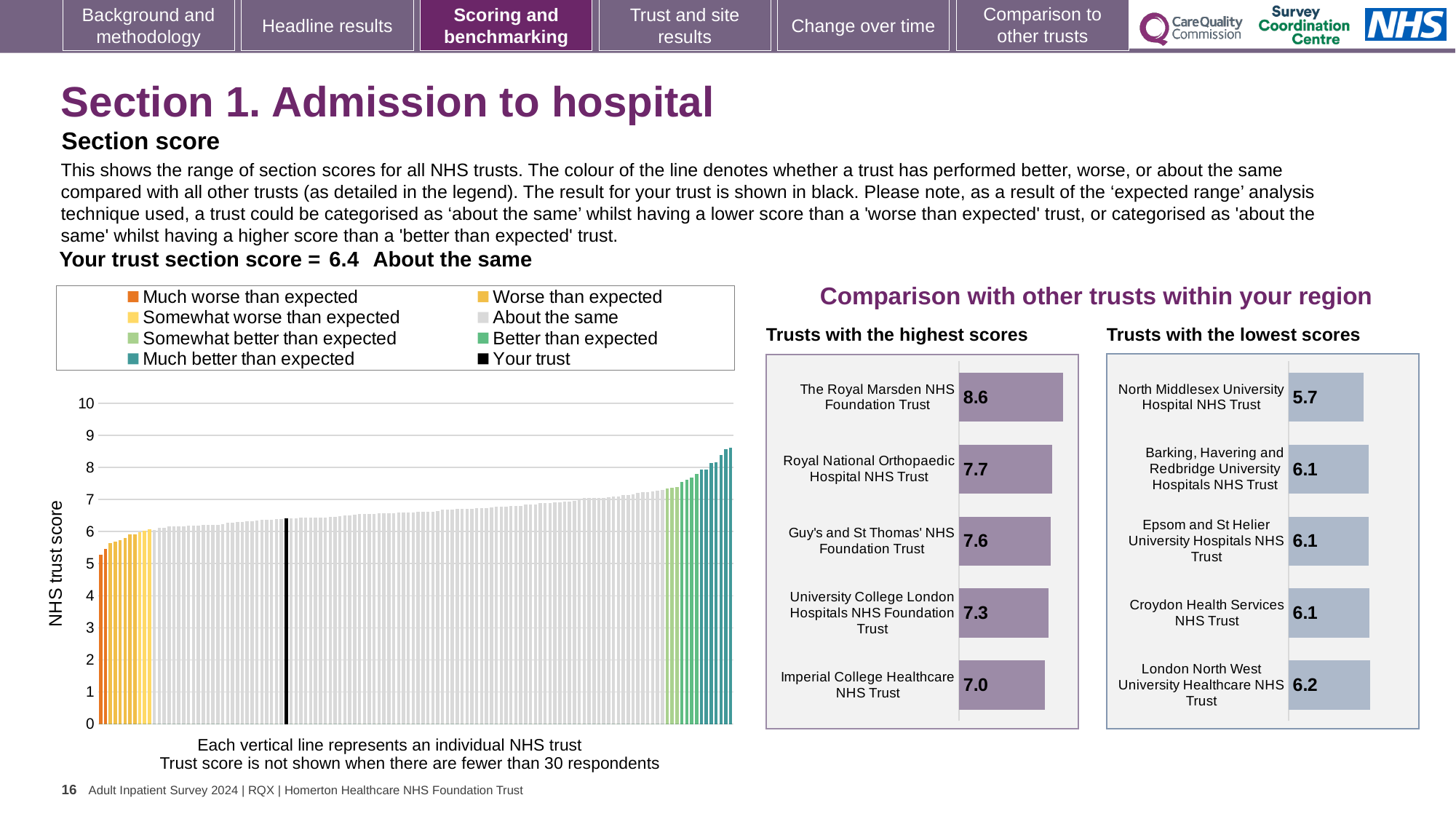
How many entries does the legend of the large chart on the left list? 8 In the 'Trusts with the lowest scores' chart, what is the difference between the scores of London North West University Healthcare NHS Trust and North Middlesex University Hospital NHS Trust? 0.5 In the 'Trusts with the highest scores' chart, what is the score for The Royal Marsden NHS Foundation Trust? 8.6 Which is larger: the score for Guy's and St Thomas' NHS Foundation Trust in the highest scores chart, or the score for Croydon Health Services NHS Trust in the lowest scores chart? Guy's and St Thomas' NHS Foundation Trust How many trusts are shown in the 'Trusts with the highest scores' chart? 5 In the 'Trusts with the highest scores' chart, what is the score for Imperial College Healthcare NHS Trust? 7.0 In the 'Trusts with the lowest scores' chart, what is the score for North Middlesex University Hospital NHS Trust? 5.7 In the 'Trusts with the lowest scores' chart, what is the score for London North West University Healthcare NHS Trust? 6.2 In the 'Trusts with the lowest scores' chart, which trust has the lowest score? North Middlesex University Hospital NHS Trust In the large chart on the left, do the trust scores rise or fall from left to right? rise In the 'Trusts with the highest scores' chart, which trust has the highest score? The Royal Marsden NHS Foundation Trust In the 'Trusts with the highest scores' chart, what is the difference between the scores of The Royal Marsden NHS Foundation Trust and Imperial College Healthcare NHS Trust? 1.6